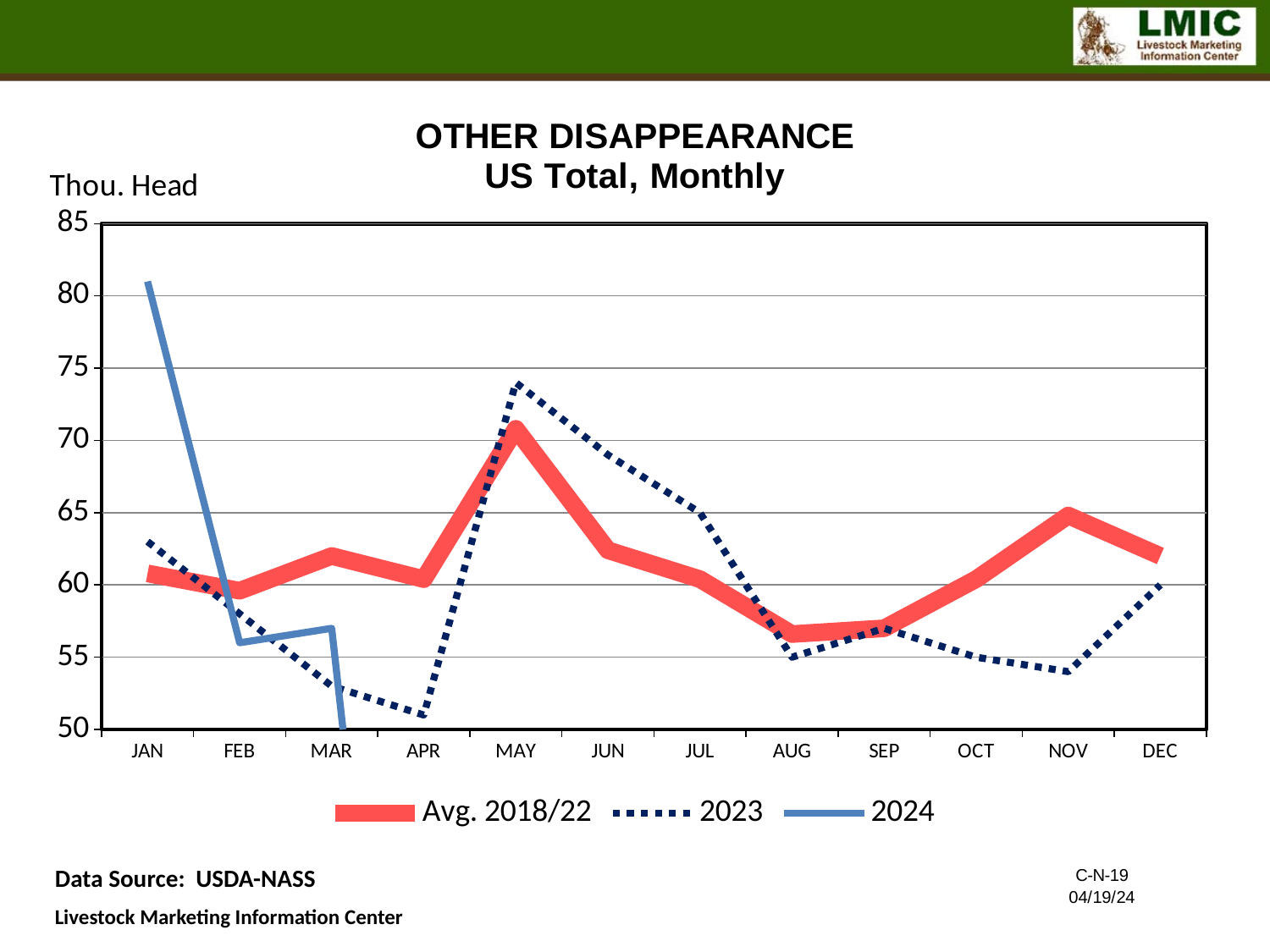
Is the value for 2024 in JAN greater or less than 75? greater How many months are shown along the x axis? 12 Is the value for 2023 in APR greater or less than 55? less Which series has the higher value in OCT, Avg. 2018/22 or 2023? Avg. 2018/22 Does the 2023 series rise or fall from MAY to AUG? fall In which month does the Avg. 2018/22 series reach its highest value? MAY Is the value for 2023 in AUG greater or less than 60? less In which month does the 2023 series reach its highest value? MAY What unit is shown on the y axis label? Thou. Head How many series does the legend list? 3 In which month does the 2023 series reach its lowest value? APR What kind of chart is shown on the slide? line chart